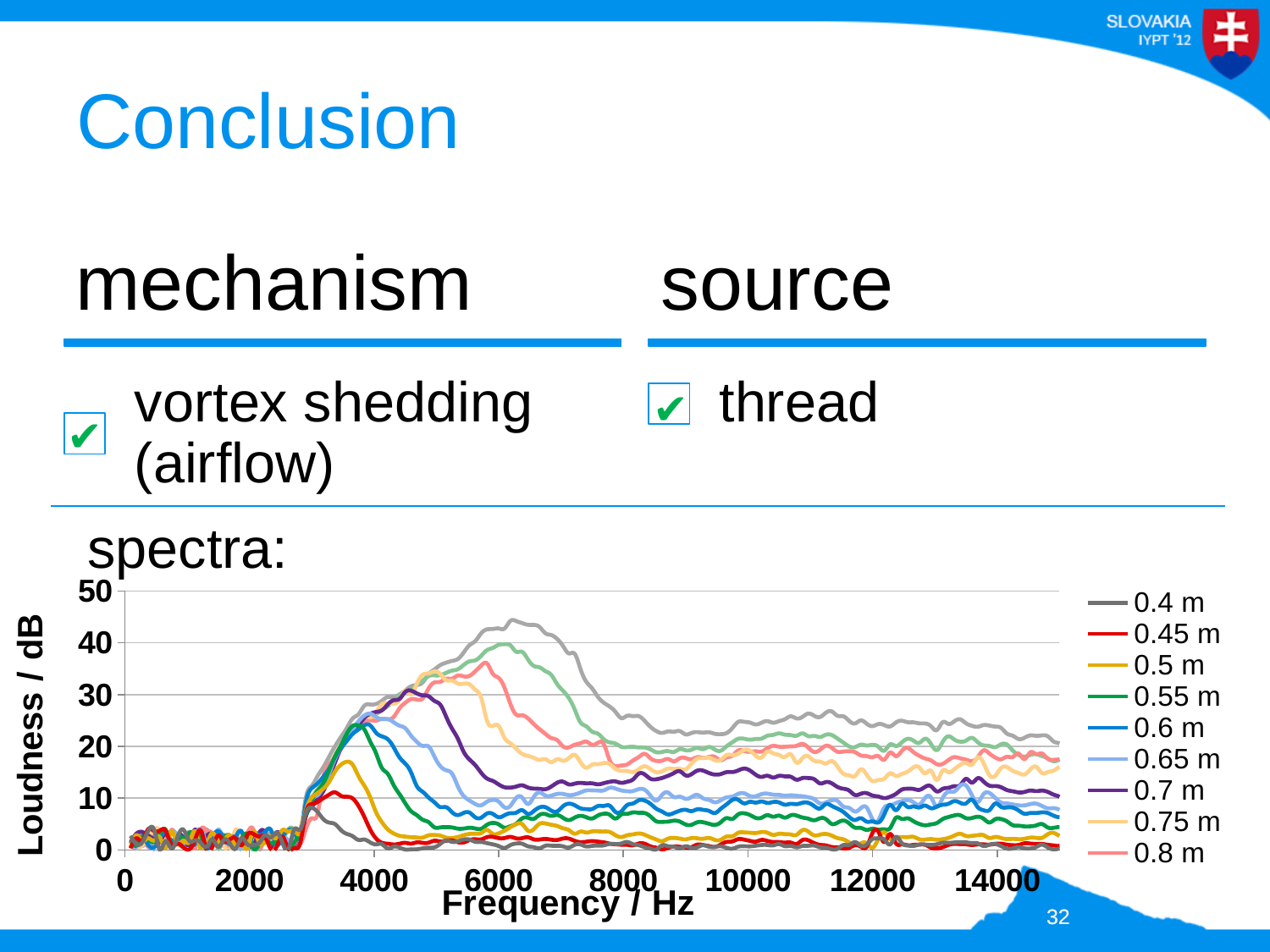
What is the label of the horizontal axis of the chart? Frequency / Hz Is the peak loudness of the 0.7 m series greater or less than 40 dB? less How many series does the chart legend list? 9 What is the label of the vertical axis of the chart? Loudness / dB Is the peak loudness of the 0.55 m series greater or less than 20 dB? greater What kind of chart is shown on the slide? line chart Is the peak loudness of the 0.8 m series greater or less than 40 dB? less